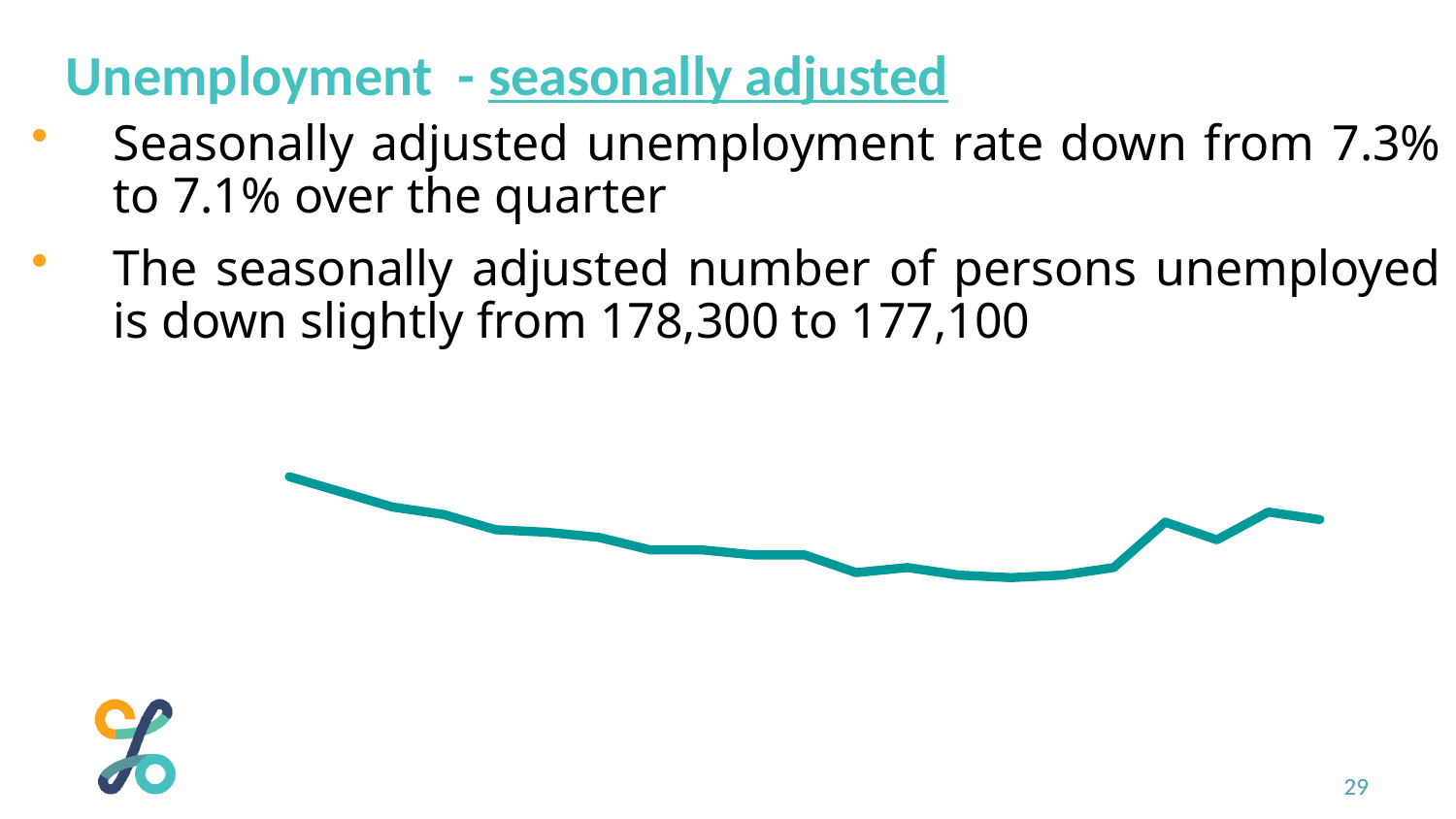
Over the first half of the chart, does the line rise or fall from left to right? fall Near the right end of the chart, does the line rise or fall compared with its lowest point? rise How many lines are plotted on the chart? 1 Does the line end higher or lower than where it starts? lower What colour is the plotted line? teal What kind of chart is shown on the slide? line chart